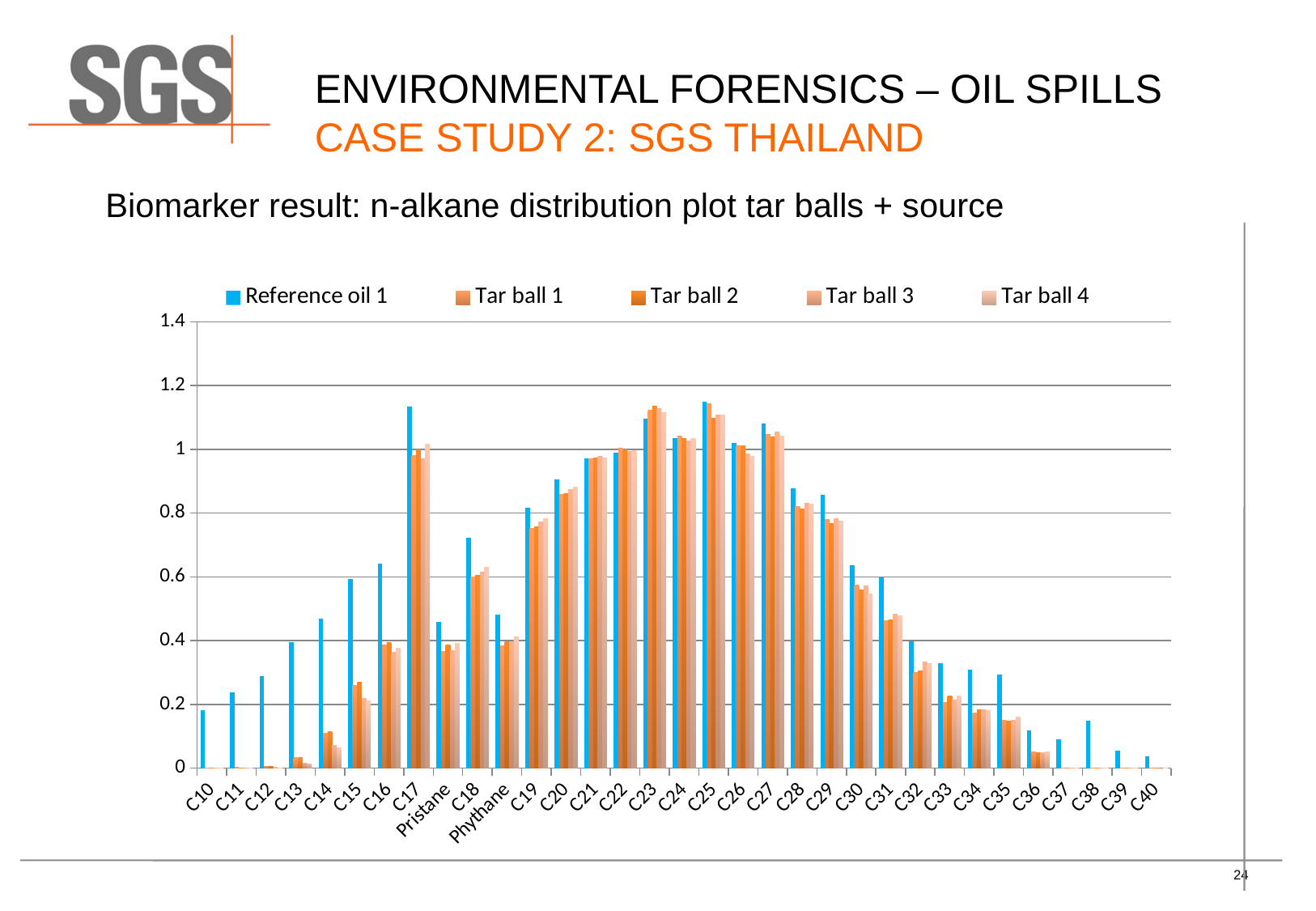
Is the value for Tar ball 1 at C14 greater or less than 0.2? less Which is larger at C14: Reference oil 1 or Tar ball 1? Reference oil 1 Which series is shown in blue in the legend? Reference oil 1 Is the value for Reference oil 1 at C28 greater or less than 0.8? greater Is the value for Reference oil 1 at C14 greater or less than 0.6? less How many series does the legend list? 5 For Reference oil 1, which is larger: the value at C17 or the value at C18? C17 Do the Reference oil 1 values rise or fall from C10 to C17? rise What kind of chart is shown on the slide? bar chart How many categories are shown along the x axis? 33